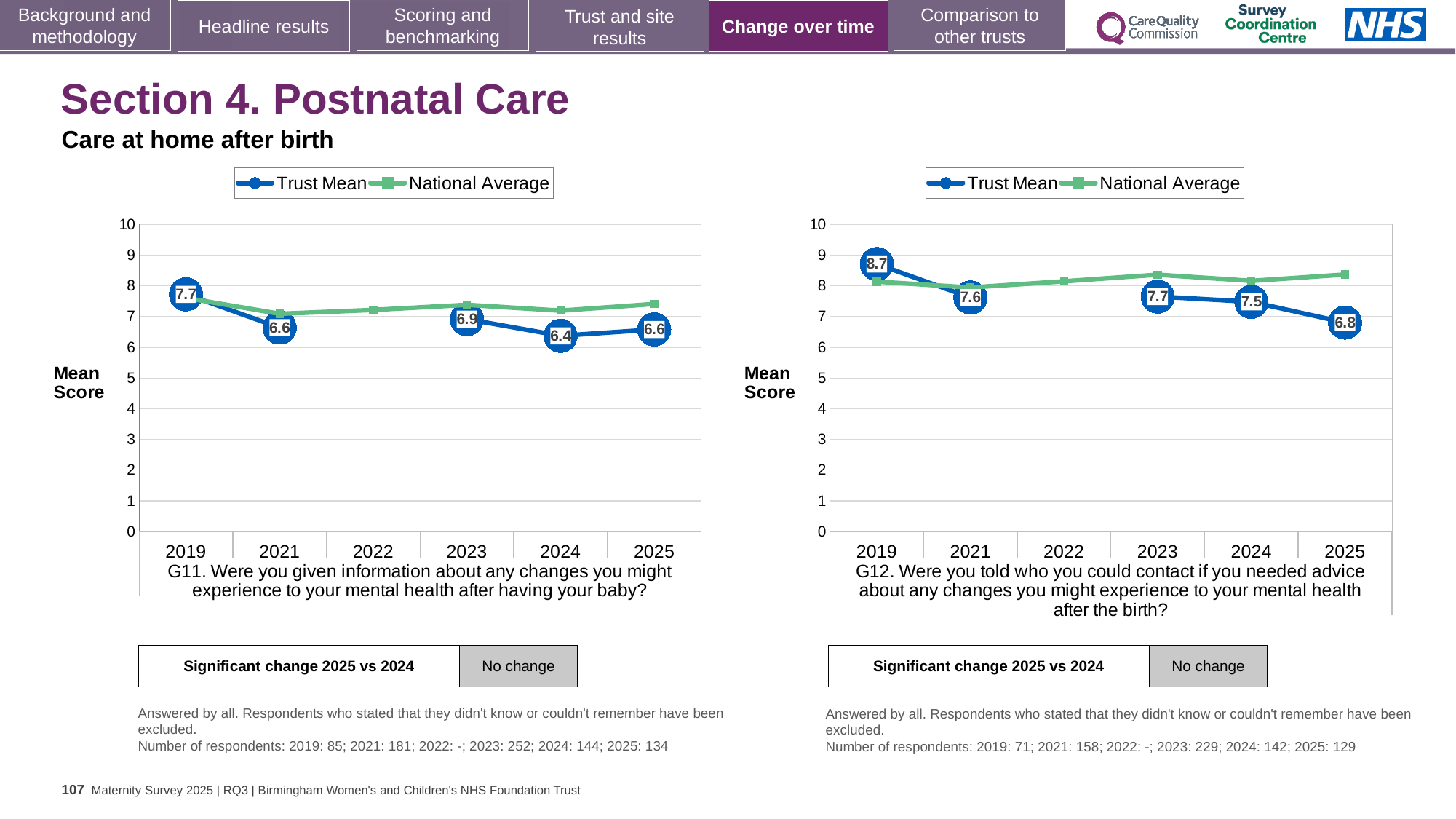
In the G12 chart, what is the Trust Mean score for 2025? 6.8 What kind of chart is the G11 chart? Line chart In the G12 chart, which year has the highest Trust Mean score? 2019 In the G11 chart, which is larger: the Trust Mean score for 2023 or for 2025? 2023 In the G11 chart, what is the Trust Mean score for 2019? 7.7 In the G11 chart, is the National Average for 2025 greater or less than 7? greater In the G11 chart, what is the Trust Mean score for 2024? 6.4 In the G12 chart, what is the difference between the Trust Mean scores for 2019 and 2025? 1.9 How many series does the legend of the G12 chart list? 2 In the G12 chart, is the National Average for 2025 greater or less than 8? greater In the G12 chart, does the Trust Mean rise or fall from 2023 to 2025? Fall In the G11 chart, which year has the lowest Trust Mean score? 2024